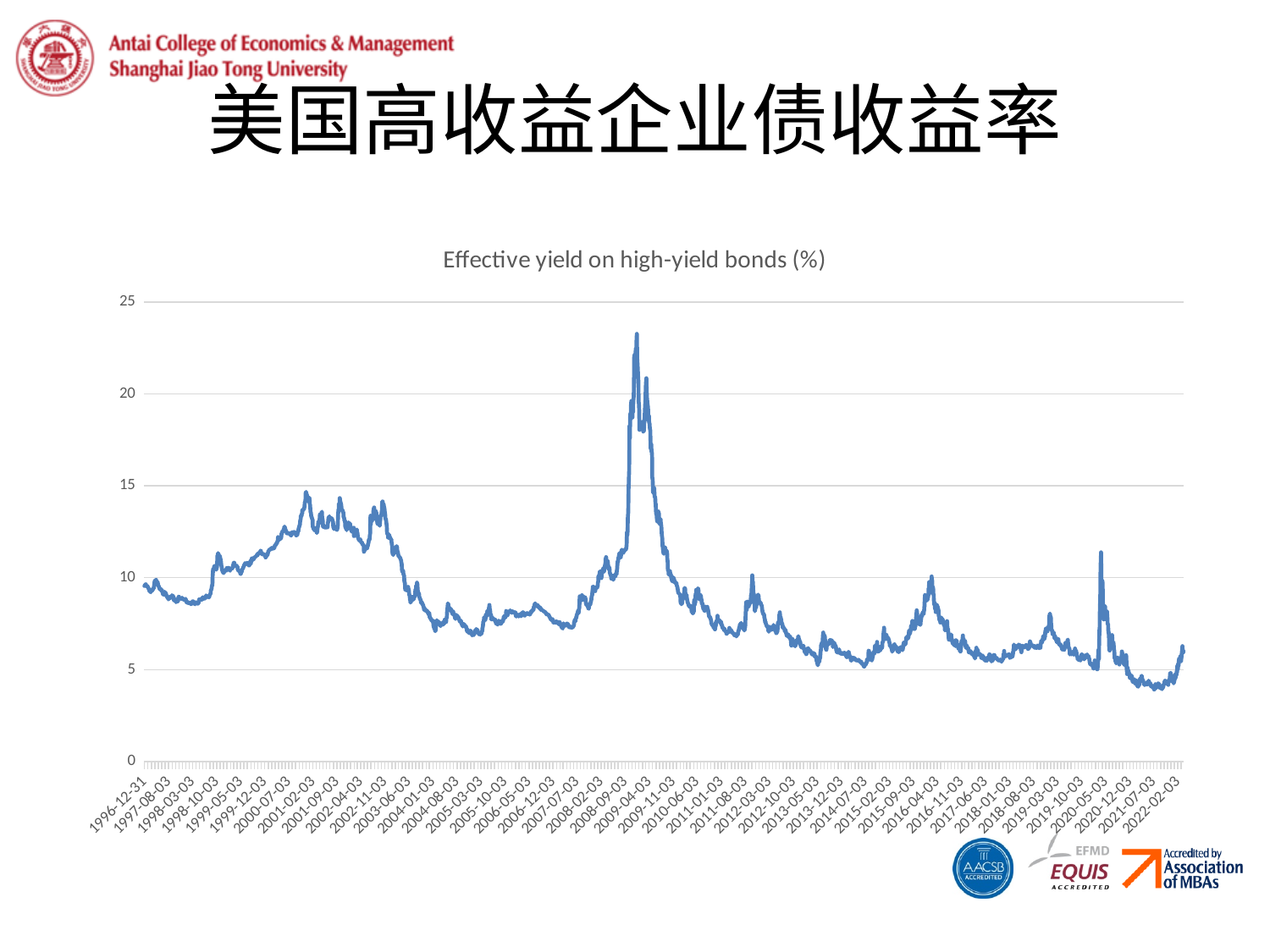
What kind of chart is shown on the slide? line chart What is the title of the chart? Effective yield on high-yield bonds (%) Does the effective yield rise or fall between its 2009 peak and 2014-07-03? fall Is the value of the effective yield around 2021-07-03 greater or less than 5? less Is the value of the effective yield around 2001-02-03 greater or less than 10? greater What is the highest value shown on the vertical axis of the chart? 25 Does the effective yield rise or fall between 2021-07-03 and 2022-02-03? rise In which period does the effective yield reach its highest point? between 2008-09-03 and 2009-04-03 Is the peak value of the effective yield, reached between 2008-09-03 and 2009-04-03, greater or less than 20? greater Is the effective yield higher around 2009-04-03 or around 2017-06-03? 2009-04-03